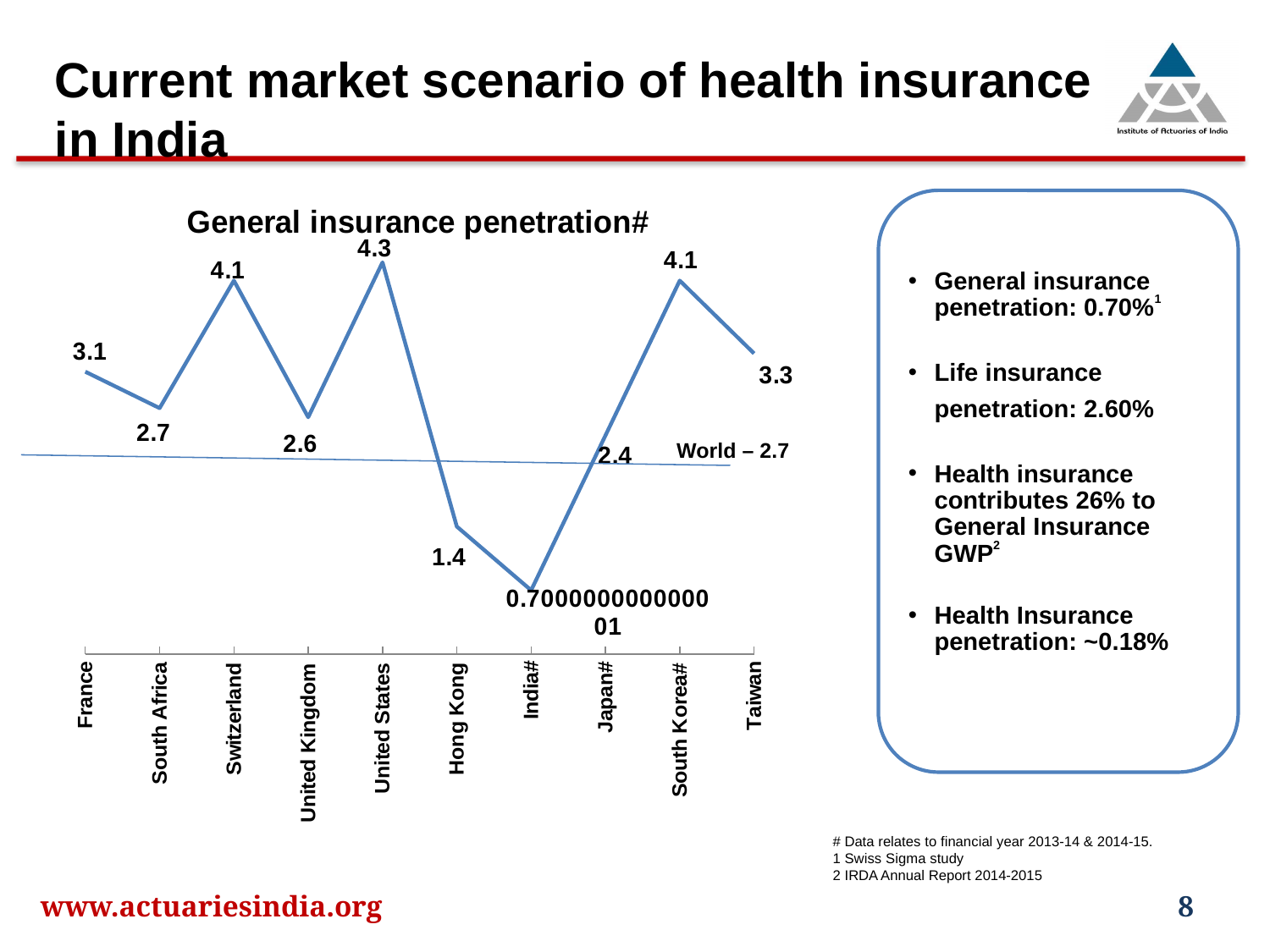
Which has a higher general insurance penetration, Taiwan or France? Taiwan What is the general insurance penetration value for Hong Kong? 1.4 What is the difference between the values for the United States and the United Kingdom? 1.7 What is the general insurance penetration value for Japan? 2.4 What is the general insurance penetration value for the United States? 4.3 Which country has the highest general insurance penetration on the chart? United States What type of chart is shown on the slide? line chart What value is shown for the World reference line on the chart? 2.7 Does the line rise or fall from Hong Kong to India? fall Which country has the lowest general insurance penetration on the chart? India What is the title of the chart? General insurance penetration# How many countries are plotted on the chart? 10